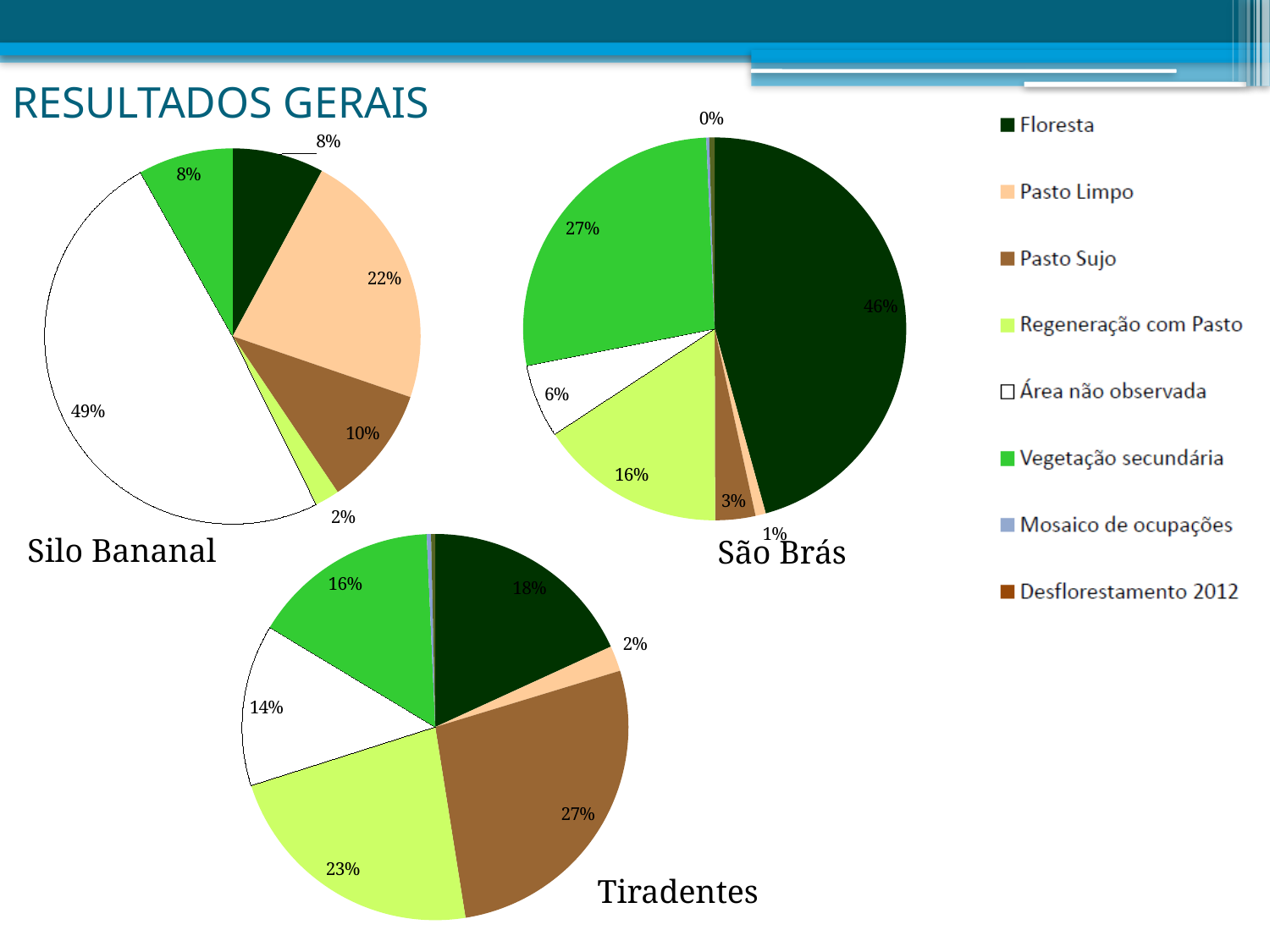
In the Tiradentes pie chart, what share is Regeneração com Pasto? 23% How many categories does the legend list? 8 In the São Brás pie chart, what share is Floresta? 46% In the Silo Bananal pie chart, which is larger, Pasto Limpo or Pasto Sujo? Pasto Limpo In the São Brás pie chart, what is the difference between the Vegetação secundária share and the Regeneração com Pasto share? 11% What type of charts are shown on the slide? Pie charts In the Silo Bananal pie chart, what share is Área não observada? 49% In the Tiradentes pie chart, which category has the largest share? Pasto Sujo In the Tiradentes pie chart, what share is Pasto Sujo? 27% In the Silo Bananal pie chart, which category has the smallest share? Regeneração com Pasto In the São Brás pie chart, which category has the largest share? Floresta In the Tiradentes pie chart, what is the difference between the Floresta share and the Área não observada share? 4%